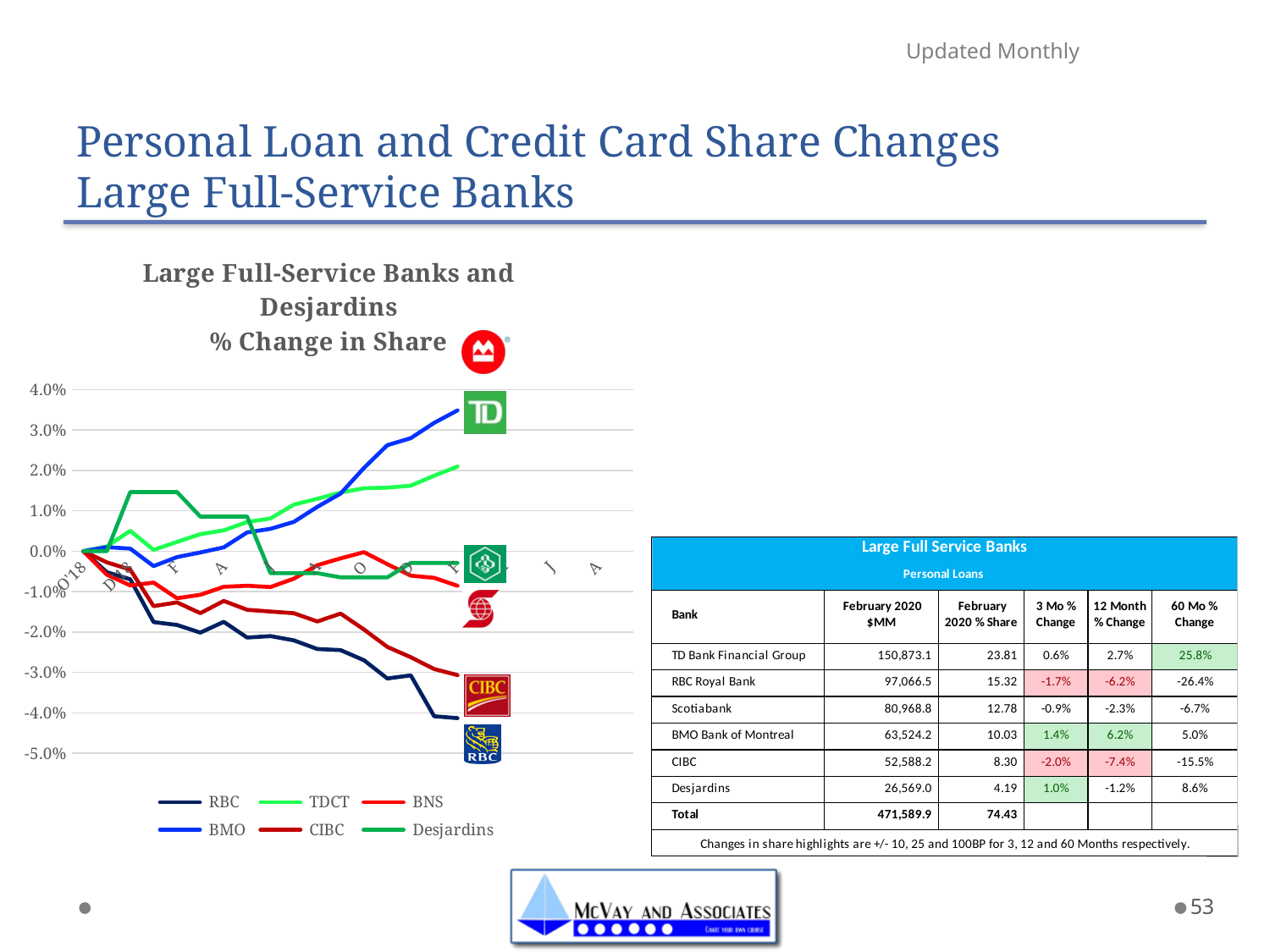
What kind of chart is shown on the slide? line chart At the right end of the chart, is the value for TDCT greater or less than 1.0%? greater How many series does the chart legend list? 6 At the right end of the chart, is the value for CIBC greater or less than -2.0%? less At the right end of the chart, is the value for BMO greater or less than 3.0%? greater At the right end of the chart, which is larger, the value for BMO or the value for TDCT? BMO Which series is drawn in light green in the chart? TDCT Which series has the highest value at the right end of the chart? BMO Which series has the lowest value at the right end of the chart? RBC Does the RBC line generally rise or fall from left to right? fall Does the BMO line generally rise or fall from left to right? rise